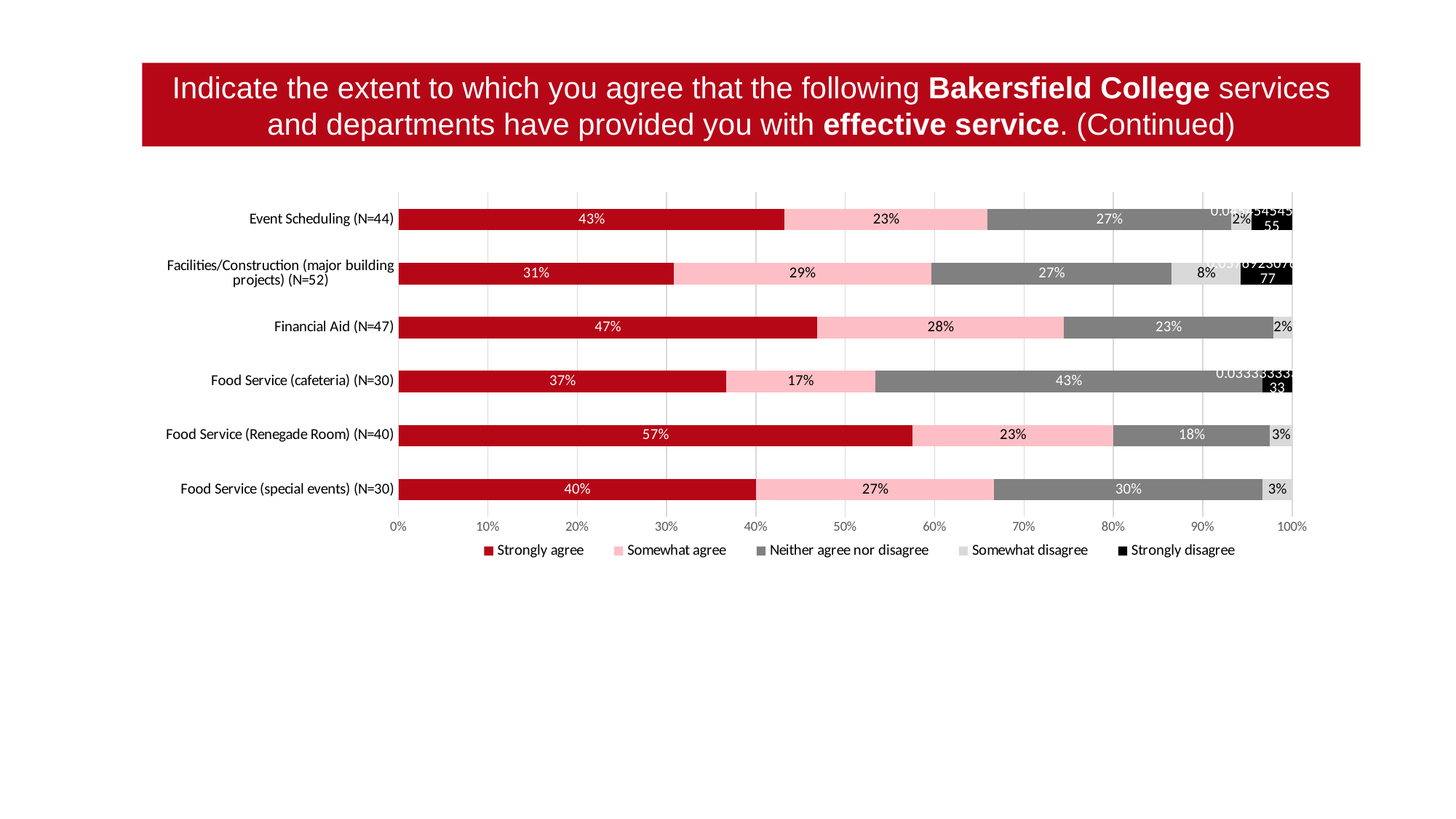
Which is larger: the Somewhat agree value for Food Service (special events) (N=30) or for Food Service (cafeteria) (N=30)? Food Service (special events) (N=30) Which service has the lowest Strongly agree value? Facilities/Construction (major building projects) (N=52) How many series does the legend list? 5 Which legend entry is shown in black? Strongly disagree Which service has the highest Strongly agree value? Food Service (Renegade Room) (N=40) What is the Somewhat disagree value for Facilities/Construction (major building projects) (N=52)? 8% What is the Strongly agree value for Food Service (Renegade Room) (N=40)? 57% What is the Neither agree nor disagree value for Food Service (cafeteria) (N=30)? 43% What is the difference between the Strongly agree values for Food Service (Renegade Room) (N=40) and Food Service (cafeteria) (N=30)? 20% What is the Somewhat agree value for Financial Aid (N=47)? 28% What type of chart is shown on the slide? stacked bar chart How many services/departments are plotted on the chart? 6